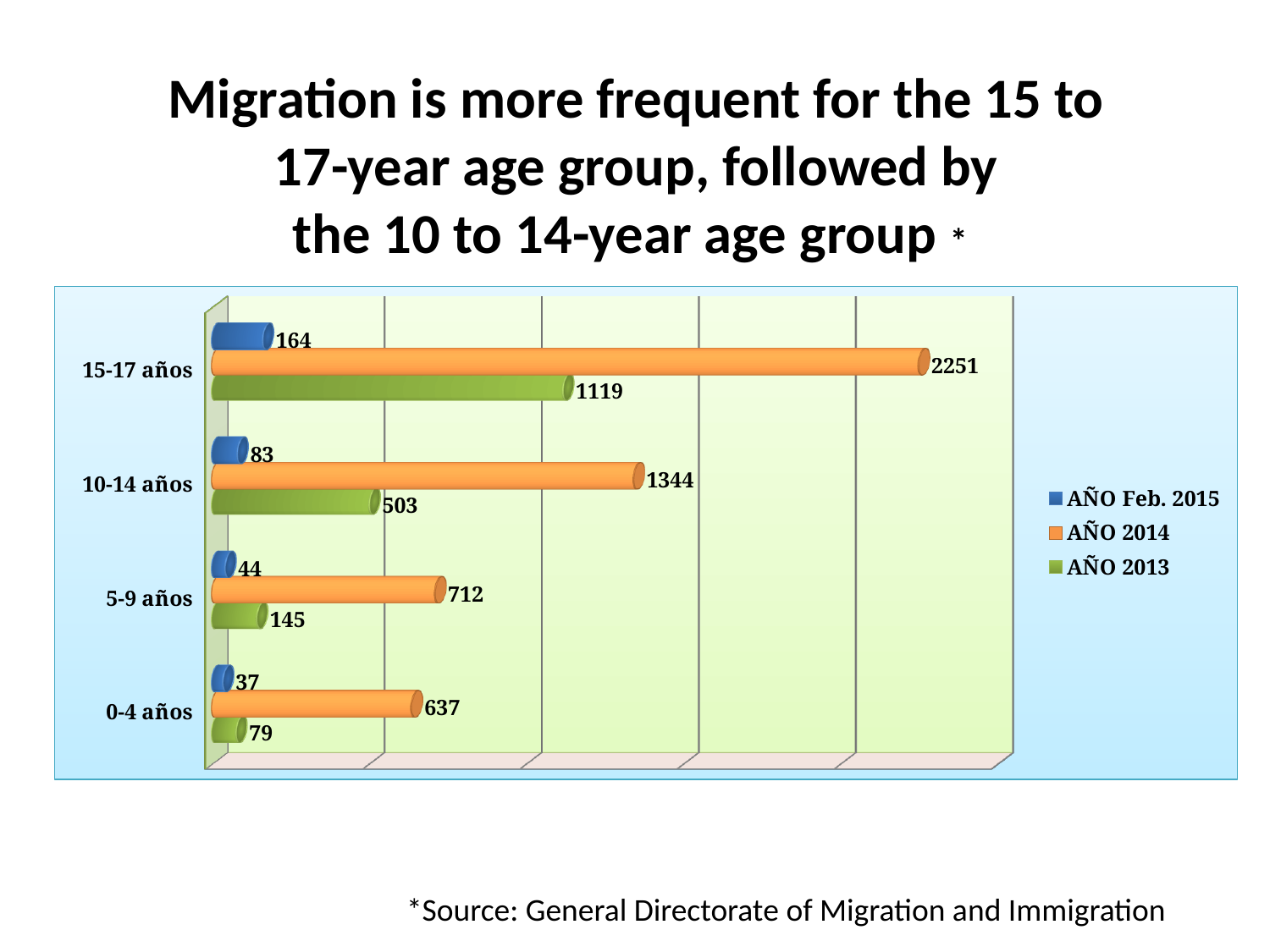
How many series does the legend list? 3 Which age group has the highest value in the AÑO 2014 series? 15-17 años What kind of chart is shown on the slide? Bar chart How many age groups are shown on the chart? 4 Which is larger for the 10-14 años group: the AÑO 2014 value or the AÑO 2013 value? AÑO 2014 What is the difference between the AÑO 2014 and AÑO 2013 values for the 15-17 años group? 1132 What is the value for the 0-4 años group in the AÑO Feb. 2015 series? 37 What is the value for the 5-9 años group in the AÑO 2014 series? 712 What is the value for the 15-17 años group in the AÑO 2014 series? 2251 What is the value for the 10-14 años group in the AÑO 2013 series? 503 Which colour represents the AÑO 2013 series in the legend? Green Which age group has the lowest value in the AÑO 2013 series? 0-4 años